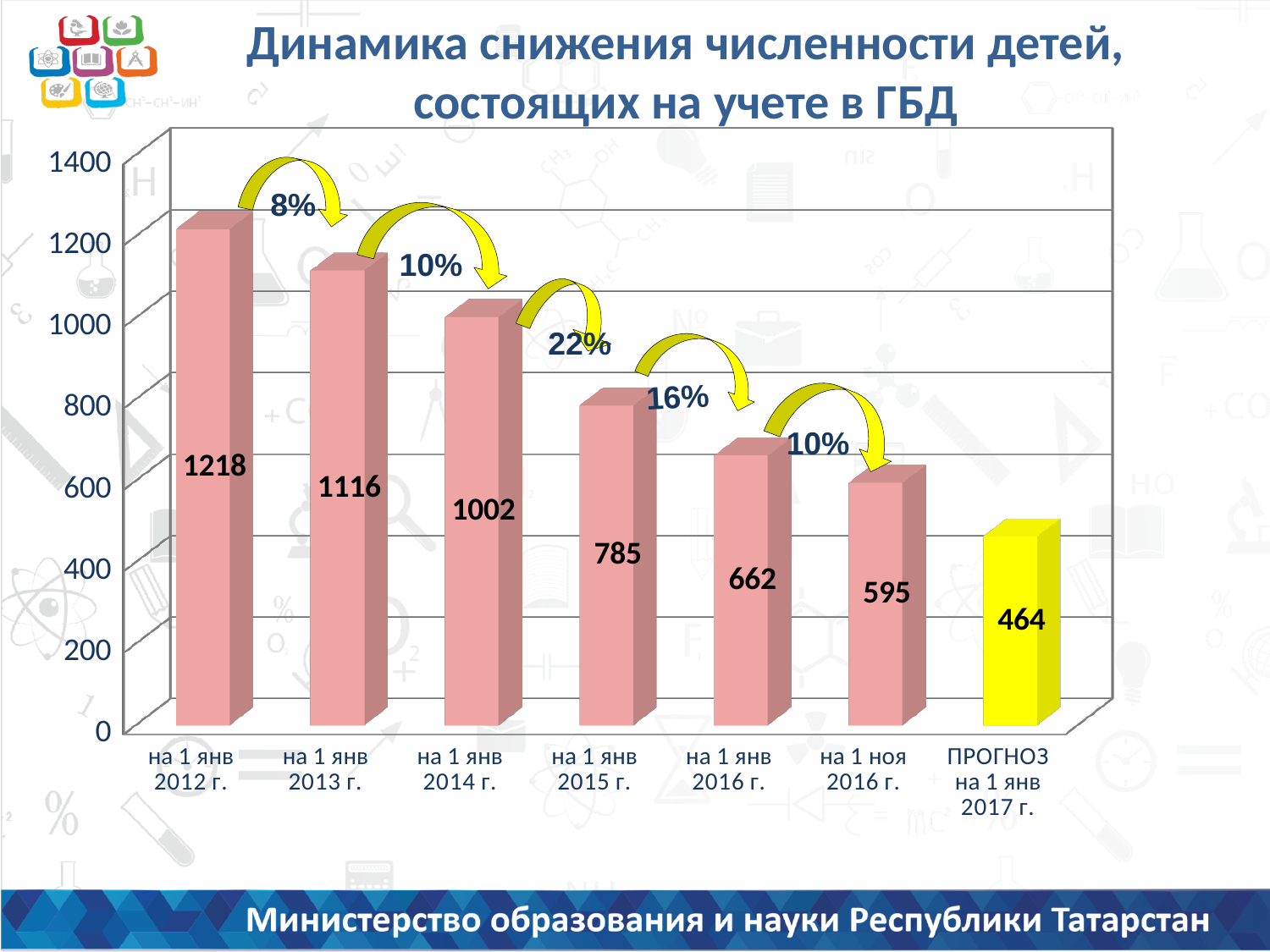
What kind of chart is this? bar chart What percentage decrease is shown between "на 1 янв 2014 г." and "на 1 янв 2015 г."? 22% Which category has the highest value? на 1 янв 2012 г. What is the value for "на 1 янв 2015 г."? 785 What is the difference between the values for "на 1 янв 2013 г." and "на 1 янв 2014 г."? 114 What is the value for "на 1 ноя 2016 г."? 595 Which category has the lowest value? ПРОГНОЗ на 1 янв 2017 г. Do the values rise or fall along the x axis? fall Which is larger, the value for "на 1 янв 2016 г." or the value for "на 1 ноя 2016 г."? на 1 янв 2016 г. What is the value for "ПРОГНОЗ на 1 янв 2017 г."? 464 How many categories are shown on the x axis? 7 What is the value for "на 1 янв 2012 г."? 1218